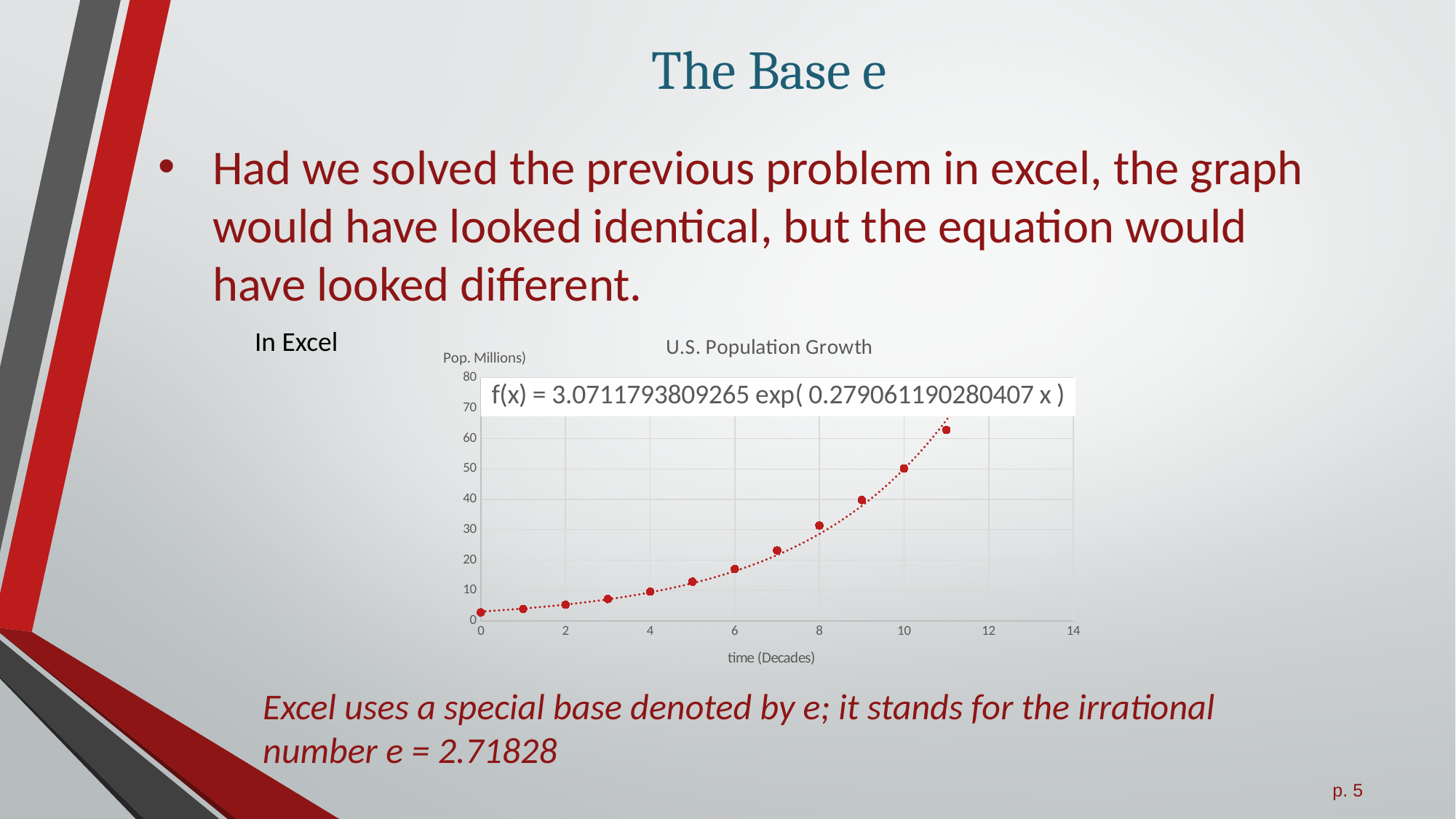
What kind of chart is shown on the slide? scatter chart What trendline equation is displayed on the chart? f(x) = 3.0711793809265 exp( 0.279061190280407 x ) Is the value at time 8 greater or less than 20? greater Is the value at time 0 greater or less than 10? less Do the plotted values rise or fall as time increases along the x axis? rise Is the value at time 5 greater or less than 20? less Which is larger, the value at time 11 or the value at time 2? time 11 At which time value (in decades) is the plotted population lowest? 0 What is the title of the chart? U.S. Population Growth